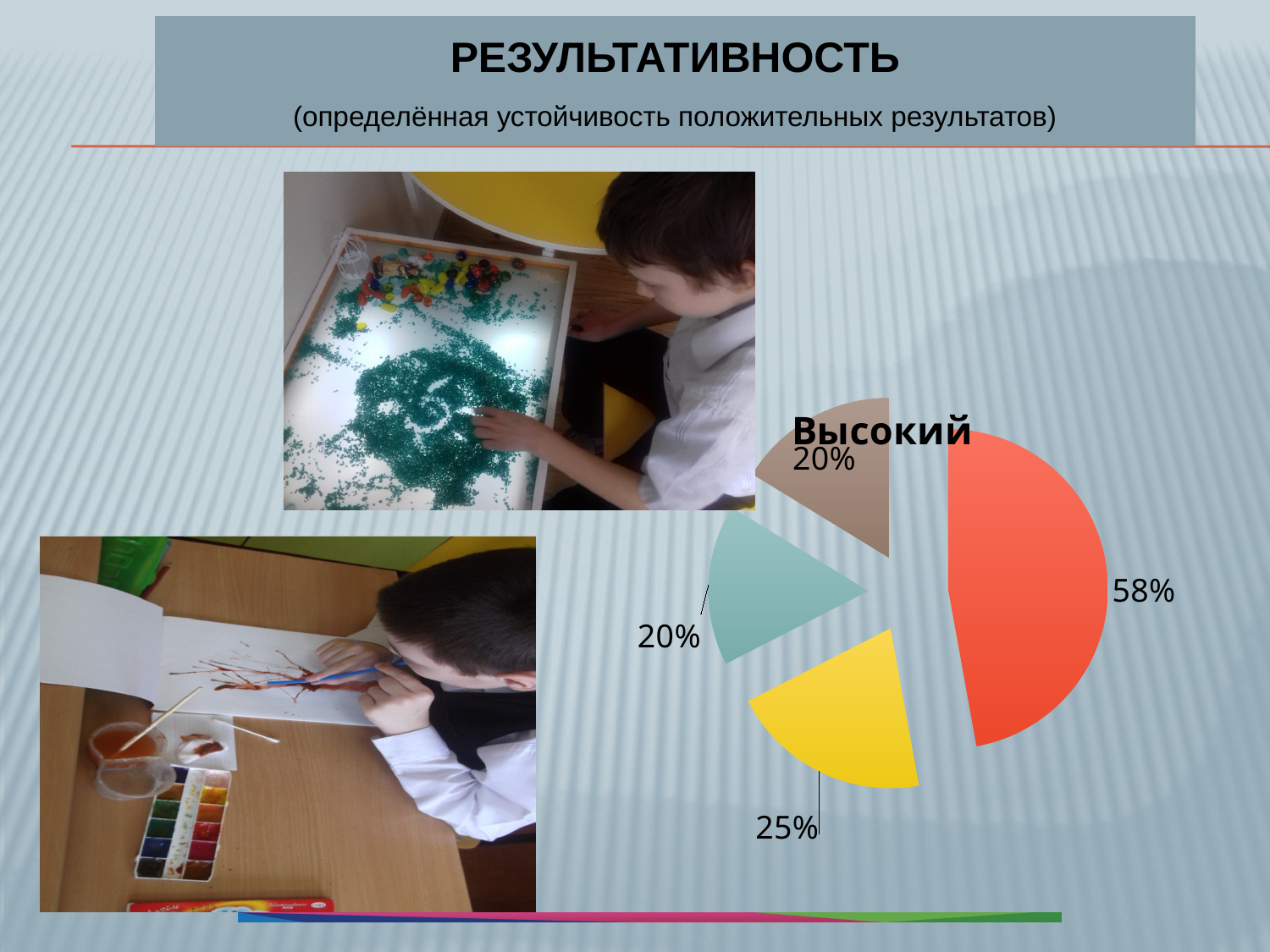
What is the difference between the yellow slice (25%) and the teal slice (20%) in the pie chart? 5% Which slice is larger in the pie chart, the red one or the yellow one? the red one What is the difference between the red slice (58%) and the yellow slice (25%) in the pie chart? 33% What value is printed on the yellow slice of the pie chart? 25% What is the value shown on the largest slice of the pie chart? 58% How many slices in the pie chart are labelled 20%? 2 What category label is printed next to the pie chart? Высокий How many slices does the pie chart have? 4 What value is printed on the teal slice of the pie chart? 20% What kind of chart is shown on the slide? pie chart What value is printed on the red slice of the pie chart? 58% What value is printed on the brown slice of the pie chart? 20%